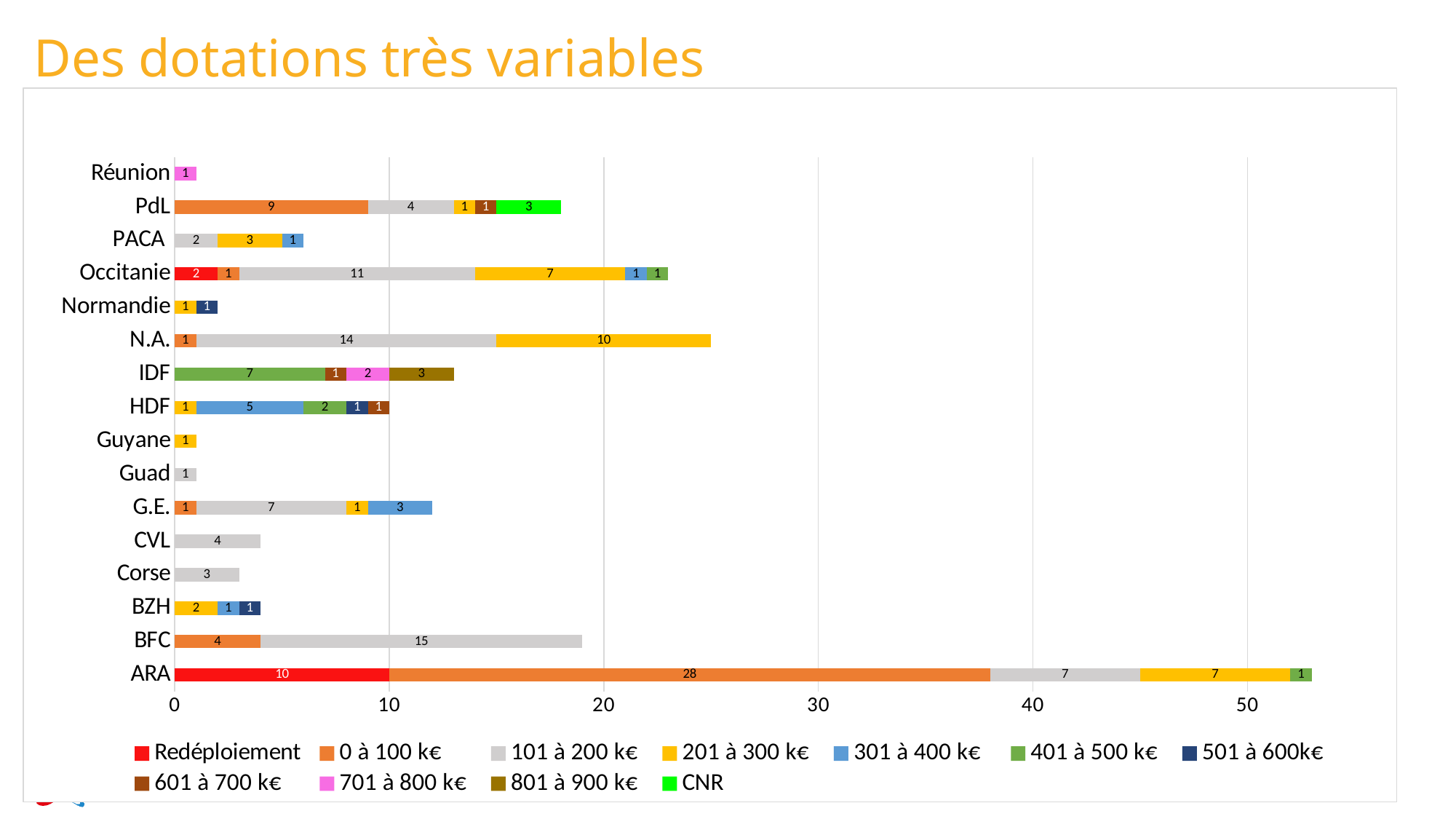
What is the total of the stacked bar for Occitanie? 23 What type of chart is shown on the slide? Stacked bar chart What is the total of the stacked bar for ARA? 53 How many series does the legend list? 11 How many regions (categories) are shown on the chart? 16 What is the title of the slide? Des dotations très variables What is the difference between the '101 à 200 k€' value for BFC and the '101 à 200 k€' value for G.E.? 8 Which region has the longest stacked bar overall? ARA Which is larger: the '201 à 300 k€' value for N.A. or the '201 à 300 k€' value for Occitanie? N.A. What is the value of the '101 à 200 k€' segment for N.A.? 14 What is the value of the 'CNR' segment for PdL? 3 What is the value of the '0 à 100 k€' segment for ARA? 28